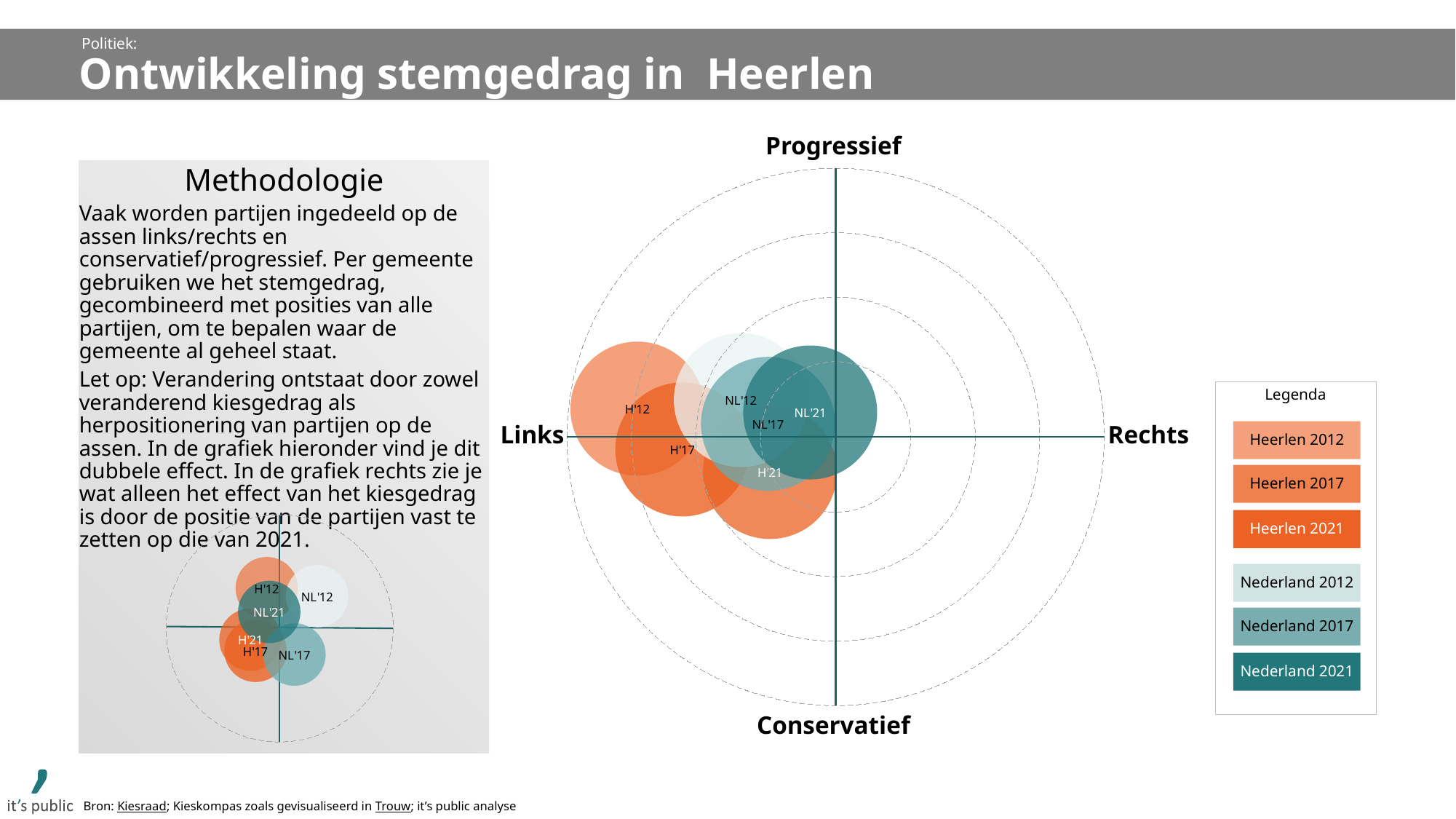
On the large chart on the right, which bubble is positioned furthest to the right (most 'Rechts')? NL'21 On the small chart inside the Methodologie box, how many labelled bubbles are plotted? 6 On the large chart on the right, how many entries does the legend list? 6 On the large chart on the right, how many labelled bubbles are plotted? 6 What kind of chart is the large chart on the right of the slide? bubble chart On the large chart on the right, which bubble is positioned further towards 'Links': H'12 or NL'21? H'12 On the large chart on the right, which bubble is positioned further towards 'Progressief': NL'12 or H'21? NL'12 On the large chart on the right, what label is at the left end of the horizontal axis? Links On the small chart inside the Methodologie box, which bubble is positioned furthest to the right? NL'12 On the small chart inside the Methodologie box, which bubble is positioned higher (more 'Progressief'): H'12 or H'17? H'12 On the large chart on the right, which bubble is positioned furthest to the left (most 'Links')? H'12 On the large chart on the right, what label is at the top of the vertical axis? Progressief